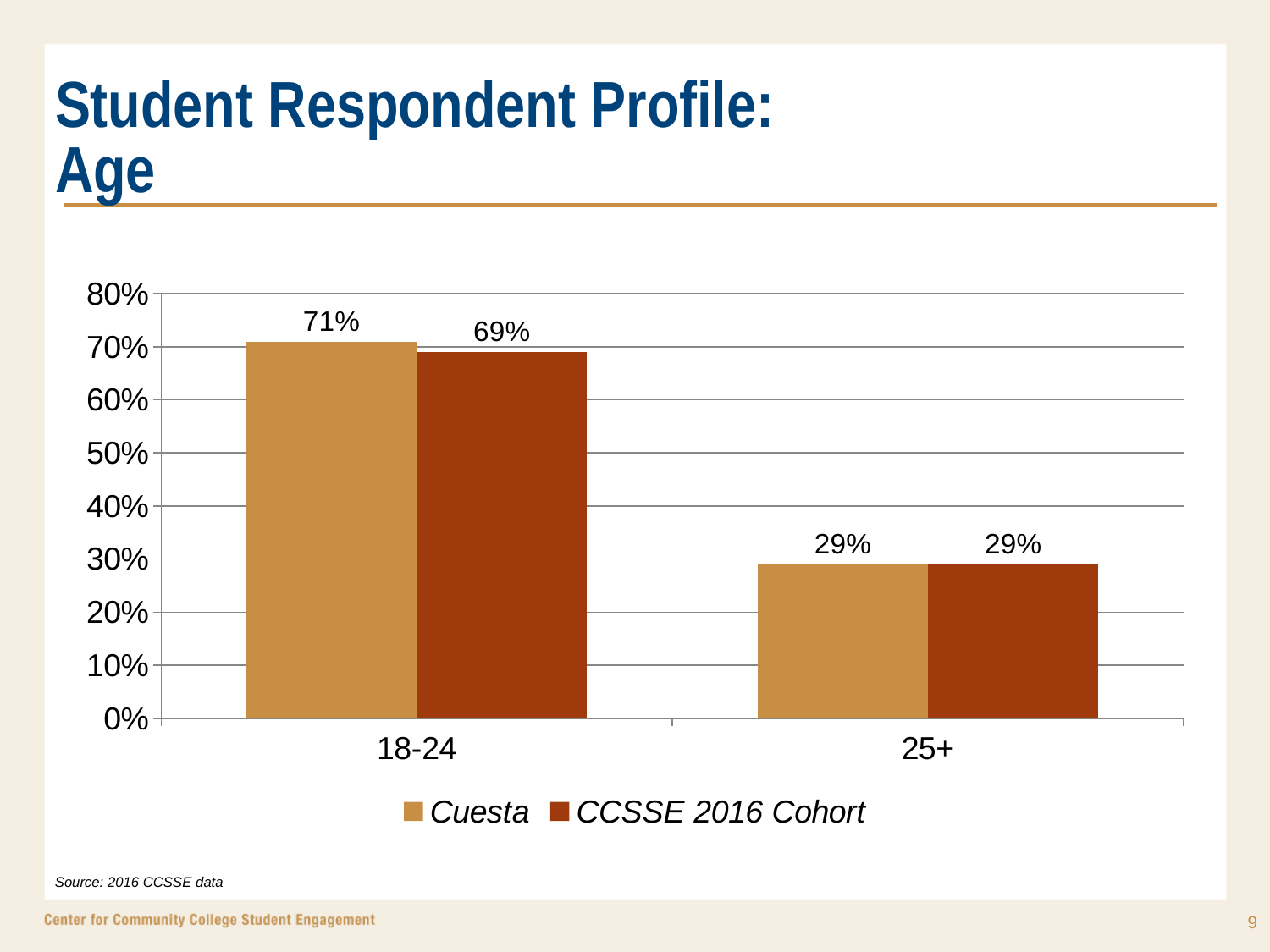
Which age group has the lowest CCSSE 2016 Cohort value? 25+ What is the CCSSE 2016 Cohort value for the 25+ age group? 29% Which age group has the highest Cuesta value? 18-24 What is the CCSSE 2016 Cohort value for the 18-24 age group? 69% What is the Cuesta value for the 18-24 age group? 71% What kind of chart is shown on the slide? bar chart How many series does the legend list? 2 Is the Cuesta value for 18-24 greater or less than 50%? greater What is the difference between the Cuesta values for 18-24 and 25+? 42% What is the Cuesta value for the 25+ age group? 29% How many age groups are shown on the x axis? 2 What is the difference between the Cuesta and CCSSE 2016 Cohort values for the 18-24 age group? 2%